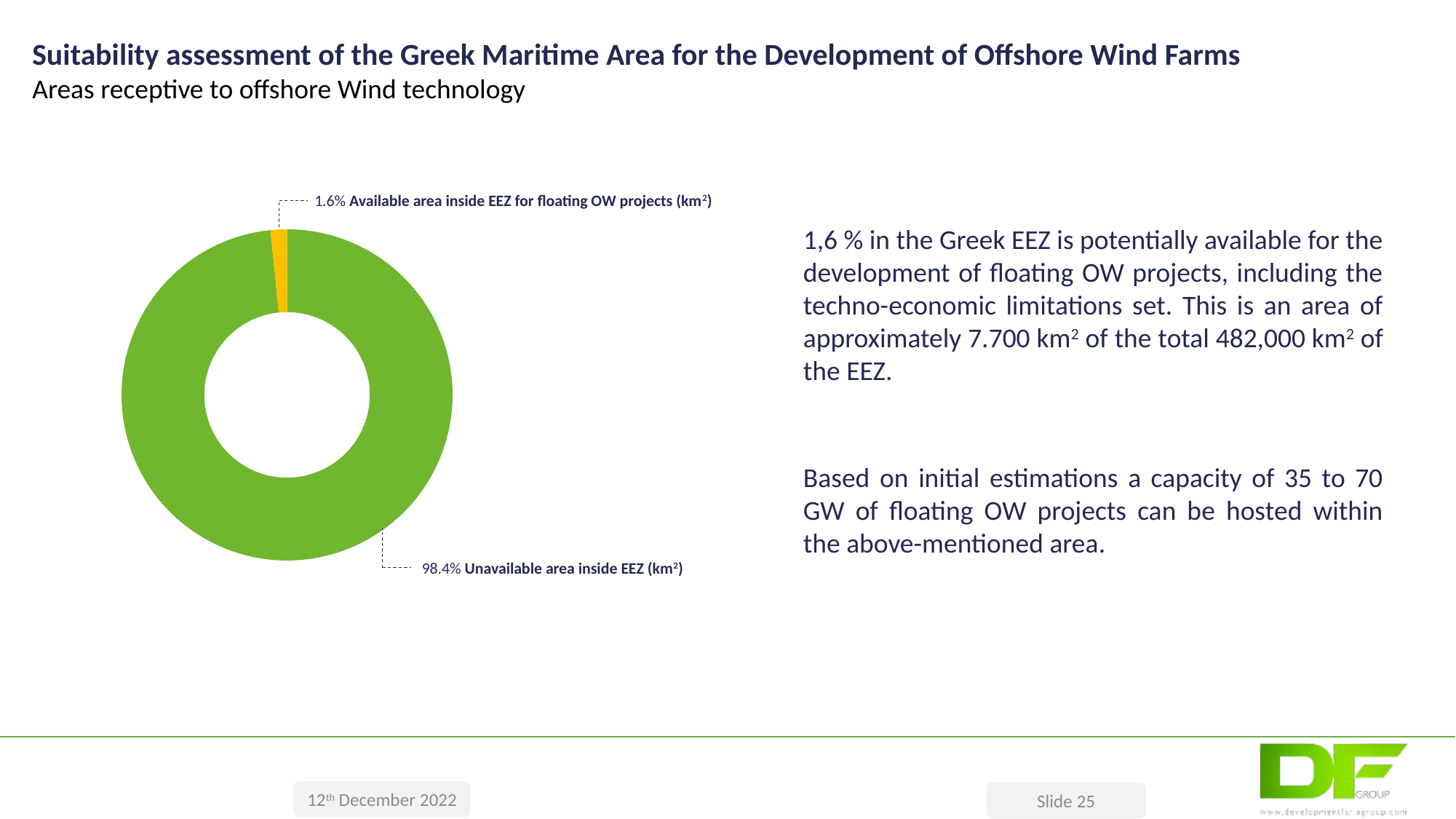
What share of the pie is labelled 'Unavailable area inside EEZ (km²)'? 98.4% Which slice of the pie is the smallest? Available area inside EEZ for floating OW projects (km²) What colour is the slice for the available area inside EEZ for floating OW projects? Yellow/orange How many slices does the pie chart have? 2 Which slice of the pie is the largest? Unavailable area inside EEZ (km²) What colour is the slice for the unavailable area inside EEZ? Green What share of the pie is labelled 'Available area inside EEZ for floating OW projects (km²)'? 1.6% What kind of chart is shown on the slide? Pie chart (doughnut) What is the difference in percentage points between the unavailable and available area slices? 96.8 Which is larger: the available area slice or the unavailable area slice? Unavailable area inside EEZ (km²)